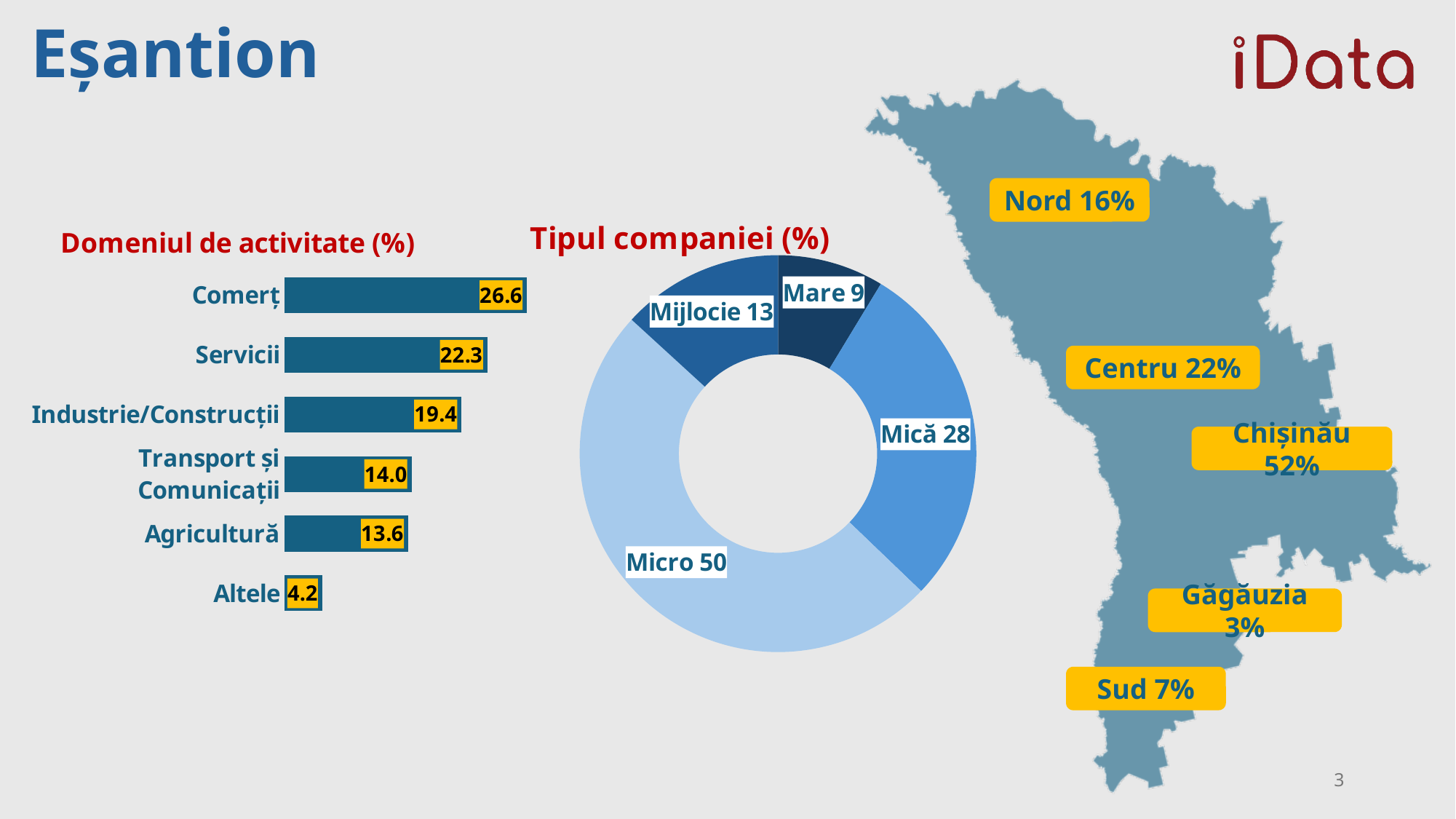
In the 'Domeniul de activitate (%)' chart, what is the difference between Servicii and Agricultură? 8.7 In the 'Tipul companiei (%)' chart, what is the difference between Mică and Mare? 19 In the 'Domeniul de activitate (%)' chart, which is larger: Industrie/Construcții or Agricultură? Industrie/Construcții How many categories does the 'Domeniul de activitate (%)' chart show? 6 In the 'Domeniul de activitate (%)' chart, which category has the lowest value? Altele In the 'Tipul companiei (%)' chart, which company type has the largest share? Micro In the 'Domeniul de activitate (%)' chart, what is the value for Comerț? 26.6 What kind of chart is 'Domeniul de activitate (%)'? Bar chart In the 'Domeniul de activitate (%)' chart, what is the value for Transport și Comunicații? 14.0 In the 'Domeniul de activitate (%)' chart, which category has the highest value? Comerț What kind of chart is 'Tipul companiei (%)'? Doughnut chart In the 'Tipul companiei (%)' chart, what is the value for Mijlocie? 13